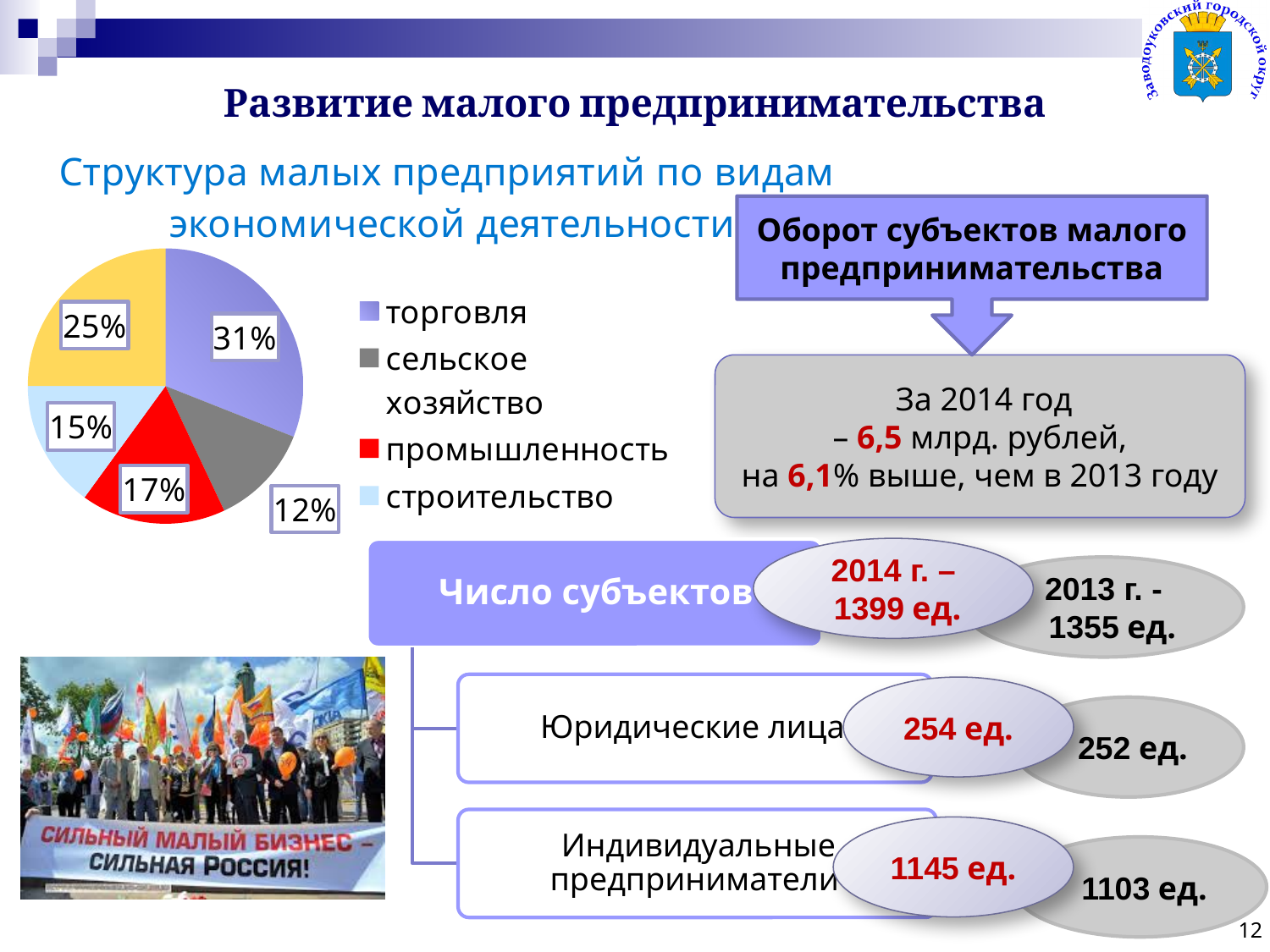
How many entries does the pie chart's legend list? 4 What percentage is shown for сельское хозяйство in the pie chart? 12% Which category has the smallest share in the pie chart? сельское хозяйство What type of chart is shown on the slide? pie chart By how many percentage points does торговля exceed промышленность in the pie chart? 14% What percentage is shown for промышленность in the pie chart? 17% How many slices does the pie chart have? 5 What percentage is shown for строительство in the pie chart? 15% What is the title of the pie chart? Структура малых предприятий по видам экономической деятельности Which labelled category has the largest share in the pie chart? торговля What share of the pie chart does торговля account for? 31% Which has a larger share in the pie chart, промышленность or строительство? промышленность